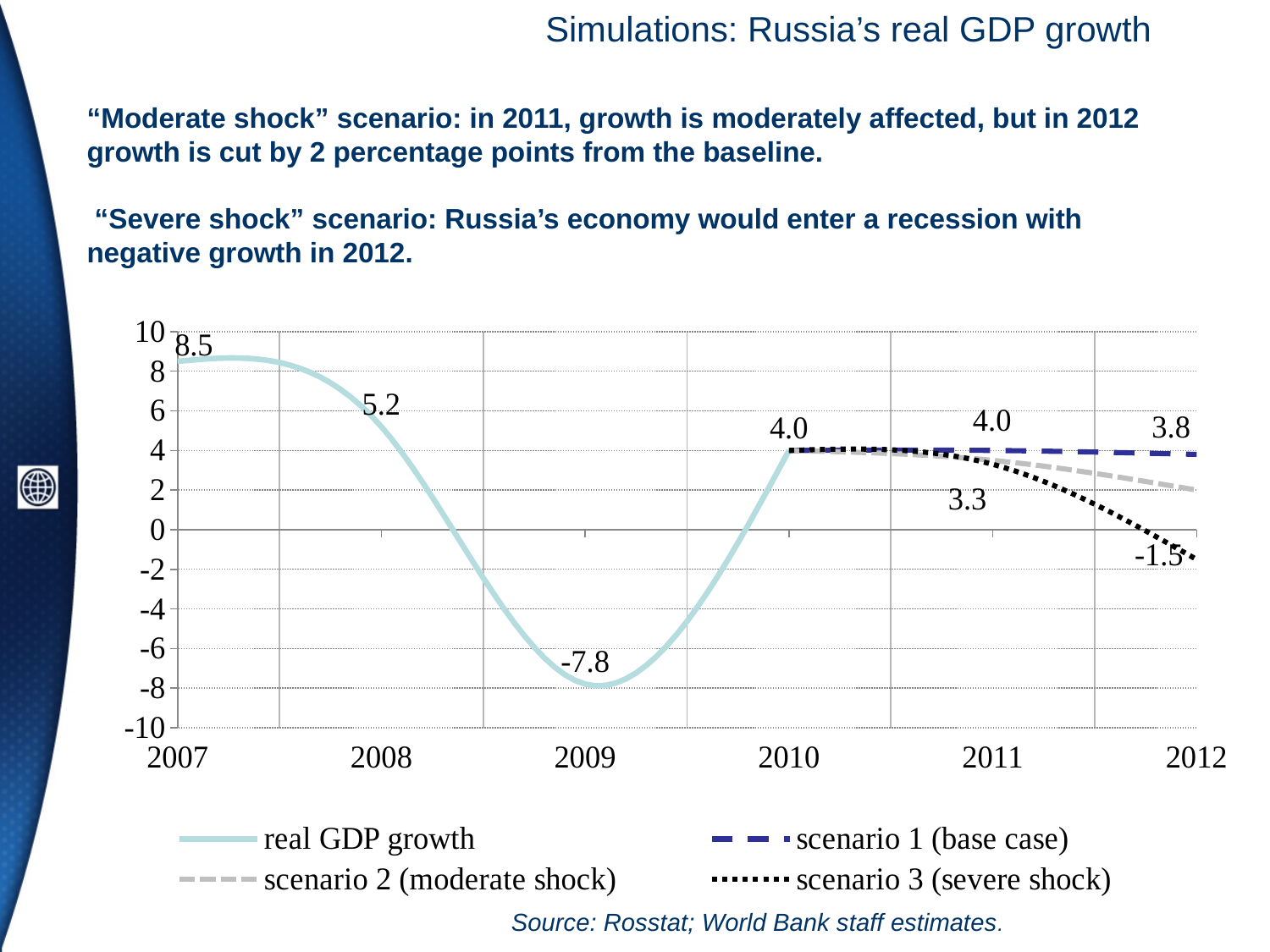
What value does scenario 3 (severe shock) show for 2012? -1.5 How many series does the legend list? 4 What is the real GDP growth value shown for 2009? -7.8 What value does scenario 3 (severe shock) show for 2011? 3.3 What kind of chart is shown on the slide? line chart In 2012, which is larger: scenario 1 (base case) or scenario 3 (severe shock)? scenario 1 (base case) What is the difference between scenario 1 (base case) and scenario 3 (severe shock) in 2012? 5.3 What value does scenario 1 (base case) show for 2012? 3.8 What is the difference between real GDP growth in 2007 and 2008? 3.3 What is the real GDP growth value shown for 2007? 8.5 In which year is real GDP growth lowest? 2009 Is the value for scenario 2 (moderate shock) in 2012 greater or less than 4? less